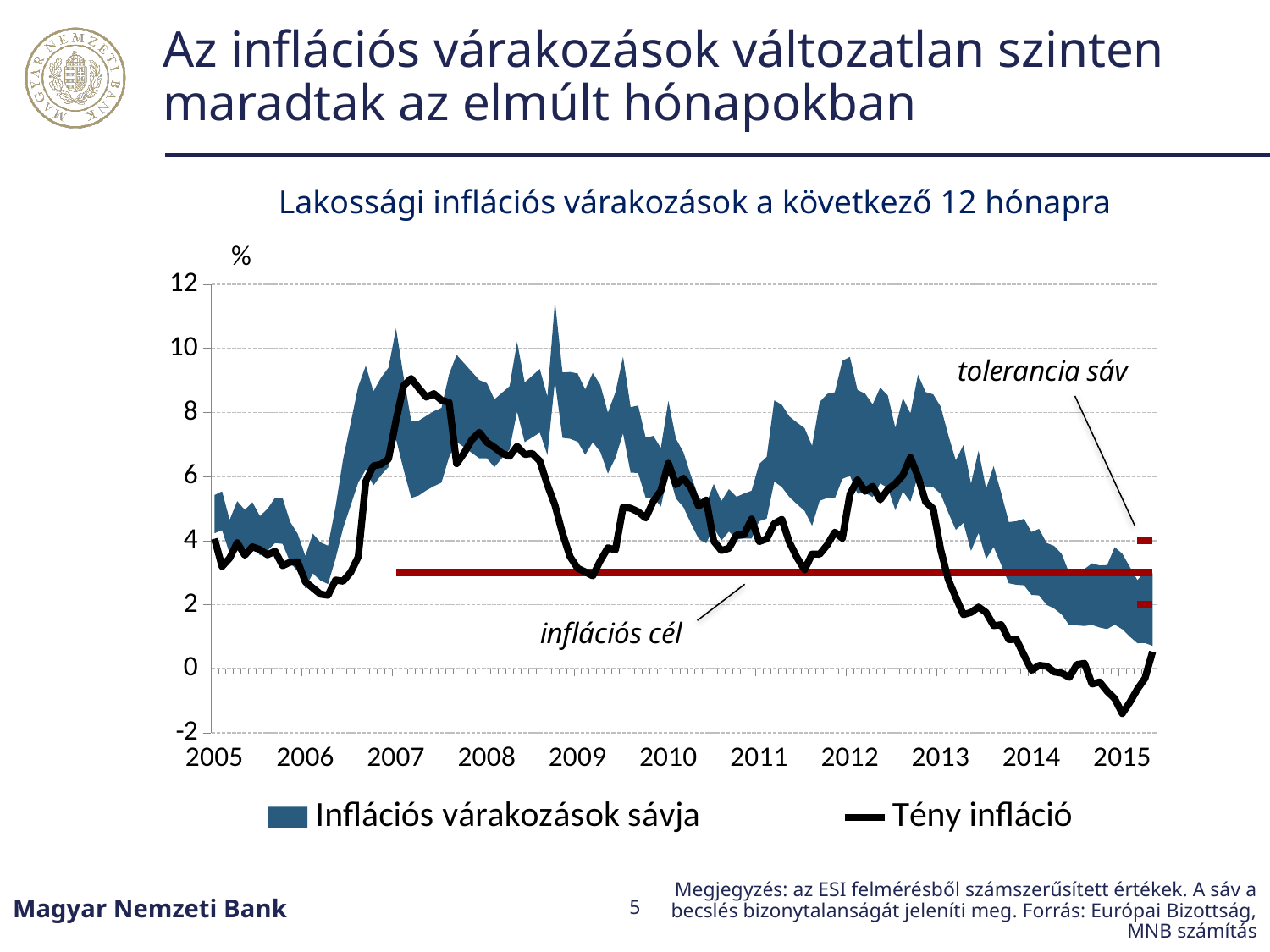
At what level is the inflációs cél line drawn on the chart? 3 What is the title of the chart? Lakossági inflációs várakozások a következő 12 hónapra Is the value of Tény infláció at the start of 2005 greater or less than 6? less Which is larger: Tény infláció at the start of 2007 or at the start of 2014? start of 2007 What kind of chart is shown on the slide? combination area and line chart How many series does the legend list? 2 What unit is shown on the vertical axis of the chart? % What is the lowest value shown on the vertical axis? -2 In which year does Tény infláció reach its highest value? 2007 Does Tény infláció rise or fall between the start of 2013 and the end of 2014? fall Is the peak value of Tény infláció in 2007 greater or less than 8? greater Is the value of Tény infláció at the end of 2014 greater or less than 0? less